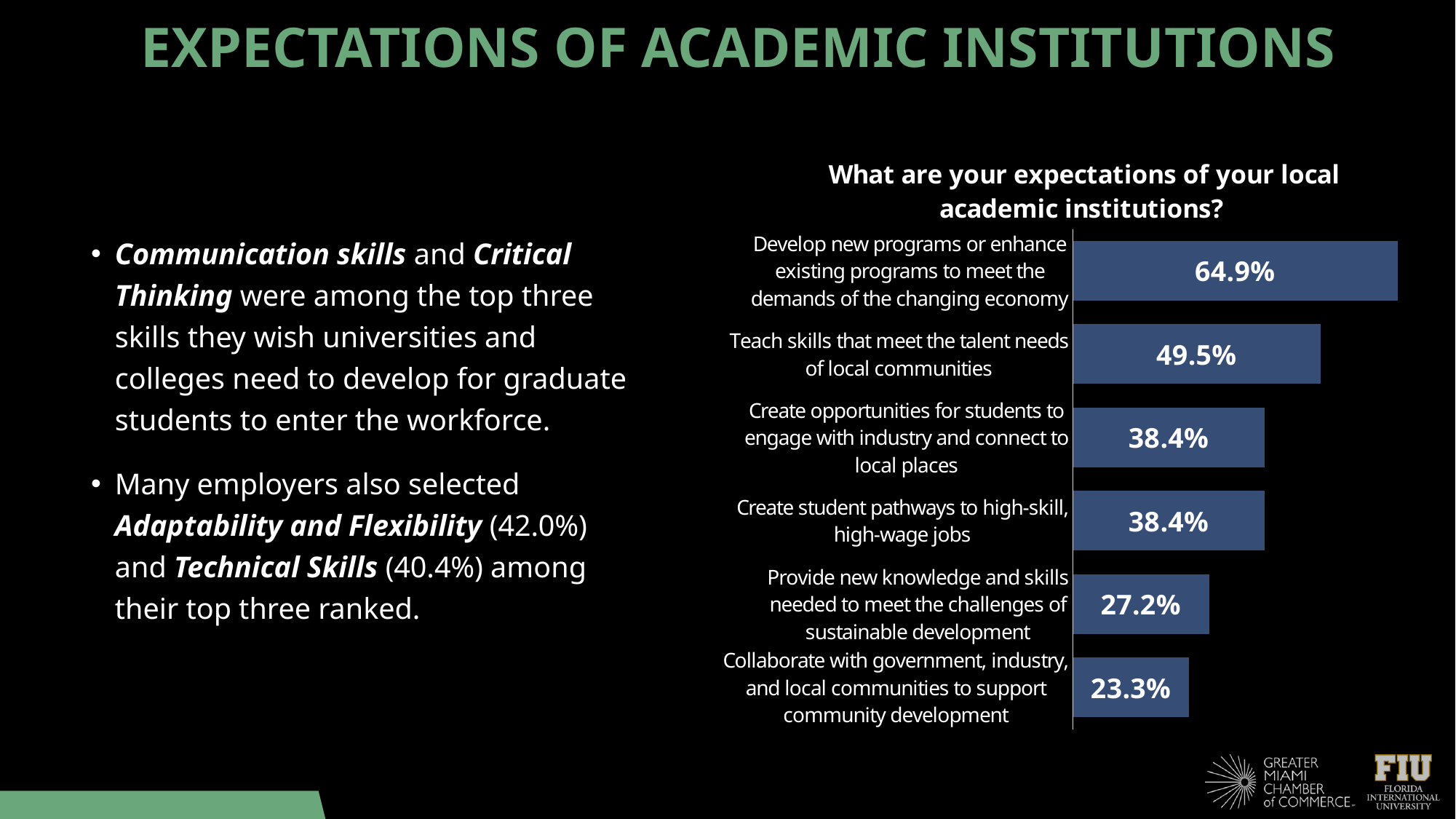
What is the value for 'Teach skills that meet the talent needs of local communities'? 49.5% How many expectation categories are shown in the chart? 6 What is the title of the chart? What are your expectations of your local academic institutions? Which expectation has the highest percentage? Develop new programs or enhance existing programs to meet the demands of the changing economy What is the value for 'Provide new knowledge and skills needed to meet the challenges of sustainable development'? 27.2% What type of chart is shown on the slide? Bar chart What percentage of respondents selected 'Develop new programs or enhance existing programs to meet the demands of the changing economy'? 64.9% What is the value for 'Collaborate with government, industry, and local communities to support community development'? 23.3% Which expectation has the lowest percentage? Collaborate with government, industry, and local communities to support community development Which two categories share the same value of 38.4%? Create opportunities for students to engage with industry and connect to local places; Create student pathways to high-skill, high-wage jobs Which is larger: the value for 'Provide new knowledge and skills needed to meet the challenges of sustainable development' or 'Collaborate with government, industry, and local communities to support community development'? Provide new knowledge and skills needed to meet the challenges of sustainable development What is the difference between the values for 'Develop new programs or enhance existing programs' and 'Teach skills that meet the talent needs of local communities'? 15.4%